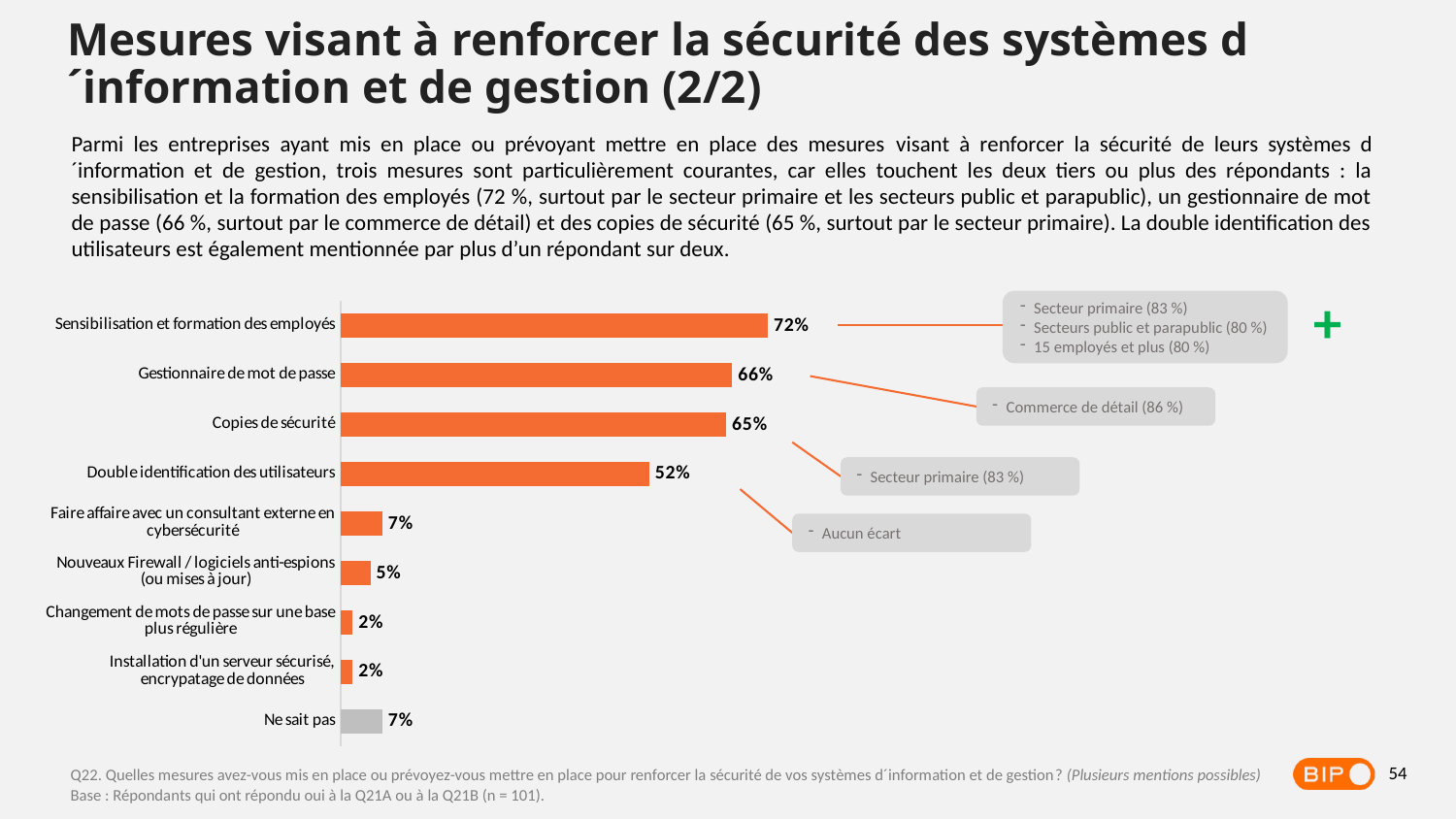
What is the value for "Sensibilisation et formation des employés"? 72% What kind of chart is shown on the slide? Bar chart Which is larger: the value for "Double identification des utilisateurs" or the value for "Copies de sécurité"? Copies de sécurité Which category has the highest value? Sensibilisation et formation des employés What is the value for "Nouveaux Firewall / logiciels anti-espions (ou mises à jour)"? 5% What is the value for "Ne sait pas"? 7% What is the value for "Copies de sécurité"? 65% What is the difference between the values for "Sensibilisation et formation des employés" and "Gestionnaire de mot de passe"? 6 percentage points What is the value for "Double identification des utilisateurs"? 52% How many categories are shown in the chart? 9 Which sector is named in the callout linked to "Gestionnaire de mot de passe"? Commerce de détail (86 %) What is the value for "Gestionnaire de mot de passe"? 66%